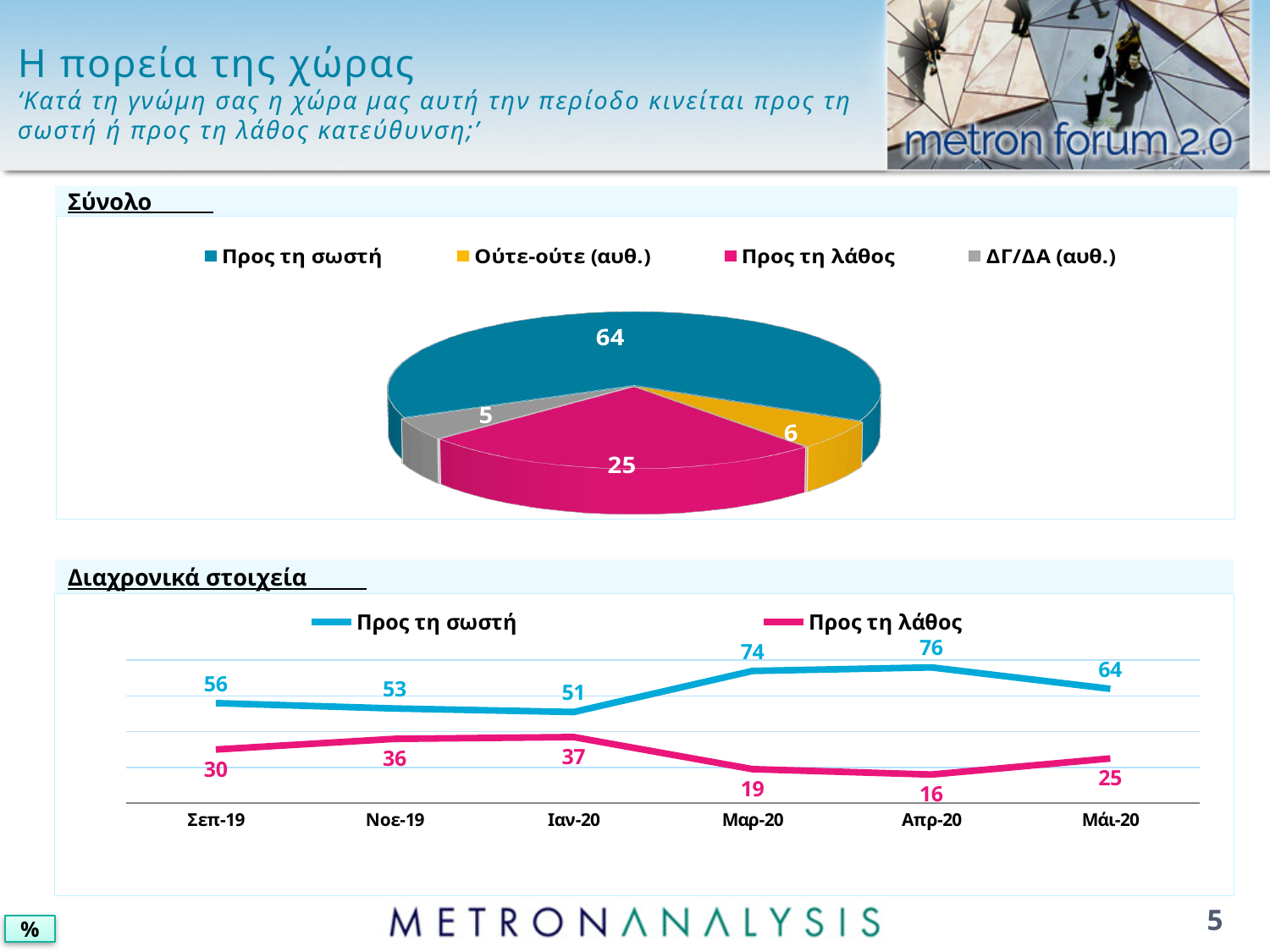
In the pie chart under 'Σύνολο', what is the value for 'Προς τη σωστή'? 64 In the pie chart under 'Σύνολο', what is the value for 'Ούτε-ούτε (αυθ.)'? 6 In the pie chart under 'Σύνολο', how many slices are there? 4 In the line chart under 'Διαχρονικά στοιχεία', how many time points are shown on the x axis? 6 In the line chart under 'Διαχρονικά στοιχεία', which is larger at Σεπ-19: 'Προς τη σωστή' or 'Προς τη λάθος'? Προς τη σωστή In the line chart under 'Διαχρονικά στοιχεία', what is the value for 'Προς τη λάθος' at Ιαν-20? 37 In the pie chart under 'Σύνολο', which category has the smallest slice? ΔΓ/ΔΑ (αυθ.) What kind of chart is shown under 'Σύνολο'? Pie chart In the pie chart under 'Σύνολο', what is the difference between 'Προς τη σωστή' and 'Προς τη λάθος'? 39 In the line chart under 'Διαχρονικά στοιχεία', what is the value for 'Προς τη σωστή' at Απρ-20? 76 In the line chart under 'Διαχρονικά στοιχεία', at which date is 'Προς τη λάθος' lowest? Απρ-20 In the line chart under 'Διαχρονικά στοιχεία', how many series does the legend list? 2